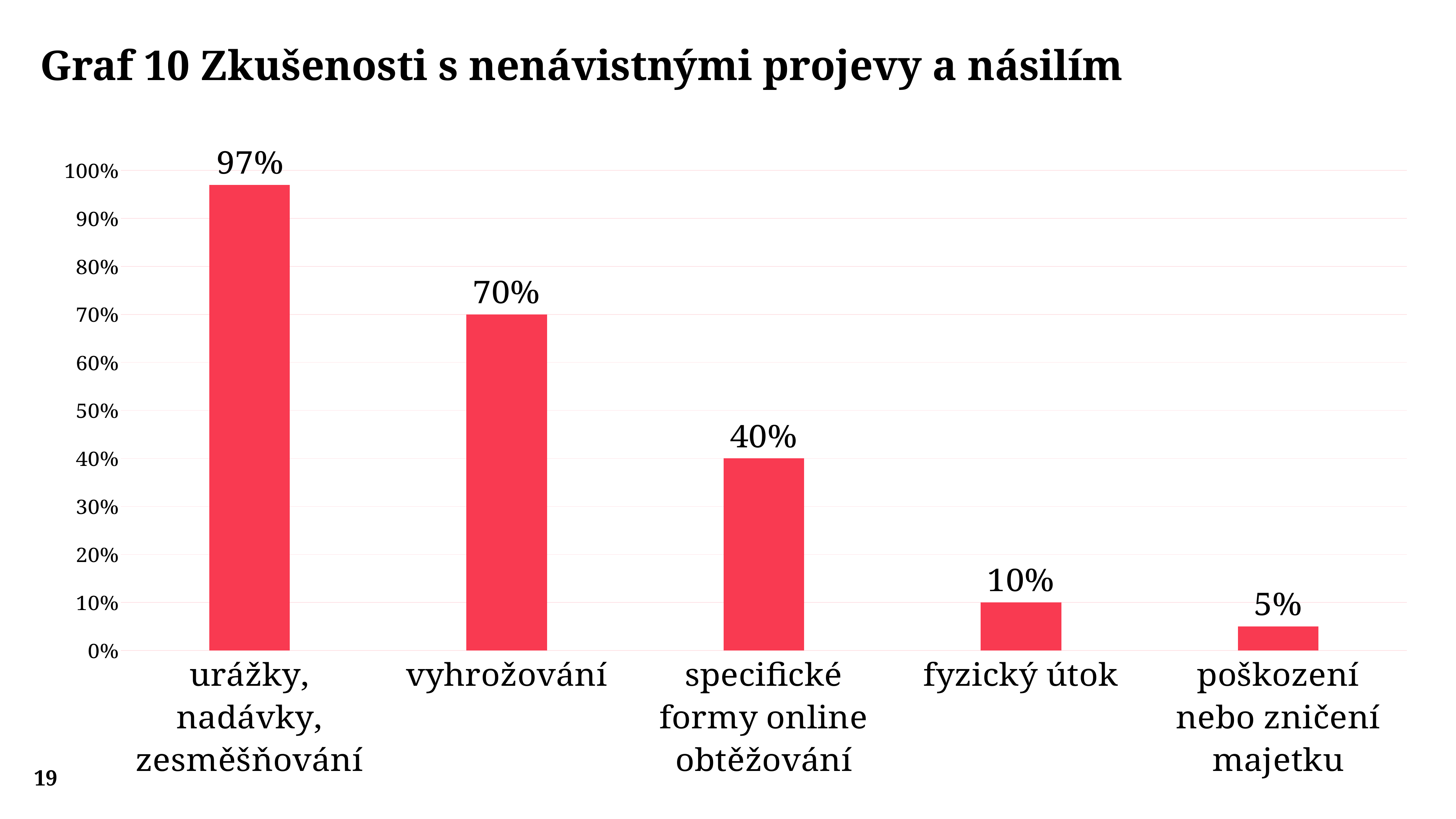
What kind of chart is shown on the slide? bar chart Which is larger, the value for "vyhrožování" or the value for "specifické formy online obtěžování"? vyhrožování What is the value for "vyhrožování"? 70% What is the value for "poškození nebo zničení majetku"? 5% What is the value for "fyzický útok"? 10% What is the difference between the values for "urážky, nadávky, zesměšňování" and "vyhrožování"? 27% What is the value for "specifické formy online obtěžování"? 40% How many categories are shown in the chart? 5 What is the difference between the values for "specifické formy online obtěžování" and "fyzický útok"? 30% Which category has the lowest value? poškození nebo zničení majetku What is the title of the chart? Graf 10 Zkušenosti s nenávistnými projevy a násilím Which category has the highest value? urážky, nadávky, zesměšňování